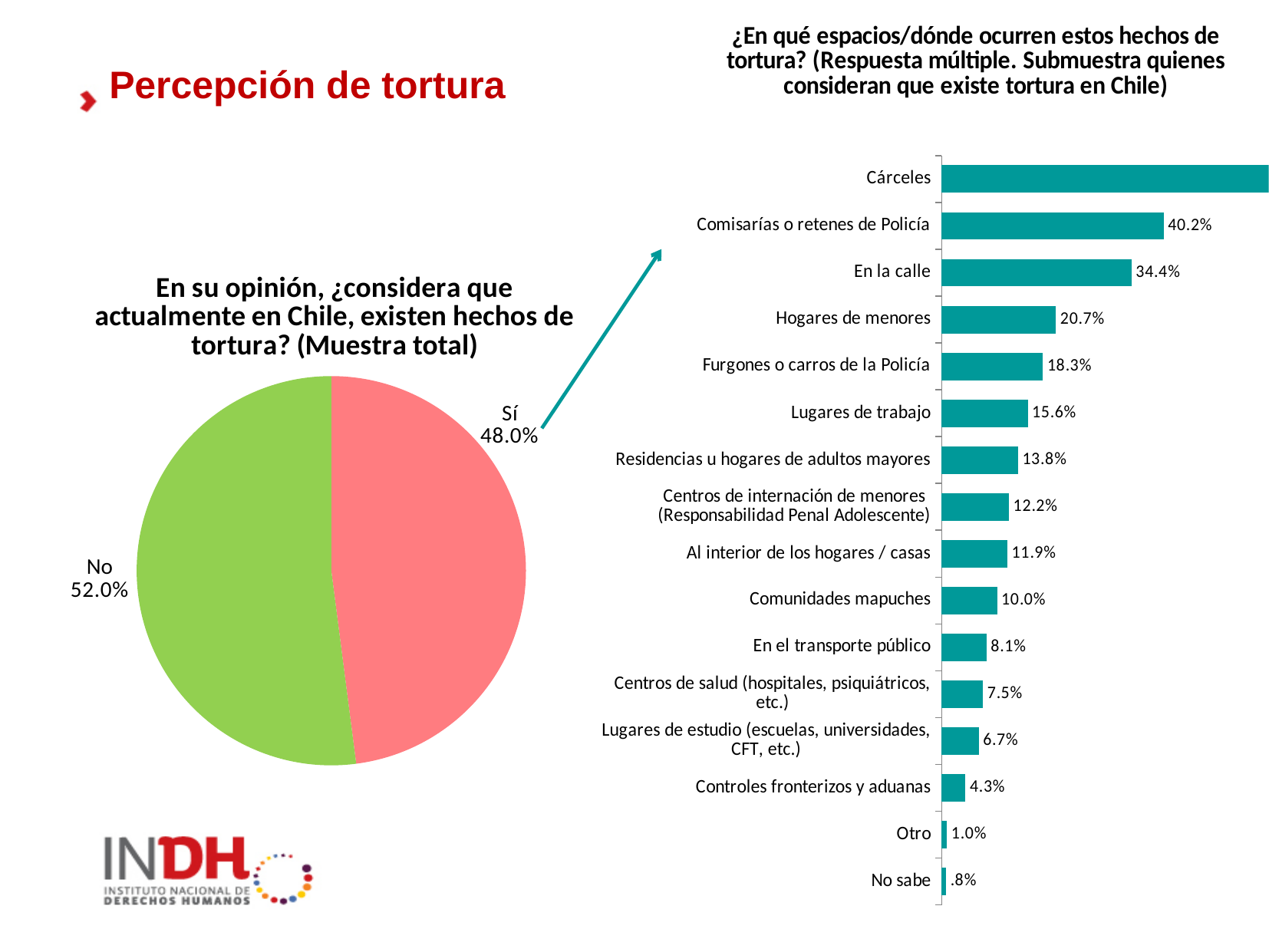
In the bar chart on the right, what is the value for "Comunidades mapuches"? 10.0% In the pie chart on the left, which slice is larger, "Sí" or "No"? No What kind of chart is the chart on the left of the slide? Pie chart In the pie chart on the left, what percentage answered "Sí"? 48.0% What kind of chart is the chart on the right of the slide? Bar chart How many categories are shown in the bar chart on the right? 16 In the pie chart on the left, what percentage answered "No"? 52.0% In the bar chart on the right, which category has the highest value? Cárceles In the bar chart on the right, what is the value for "Comisarías o retenes de Policía"? 40.2% In the bar chart on the right, which is larger, "Lugares de trabajo" or "Furgones o carros de la Policía"? Furgones o carros de la Policía In the bar chart on the right, what is the difference between "En la calle" and "Hogares de menores"? 13.7% In the bar chart on the right, which category has the lowest value? No sabe